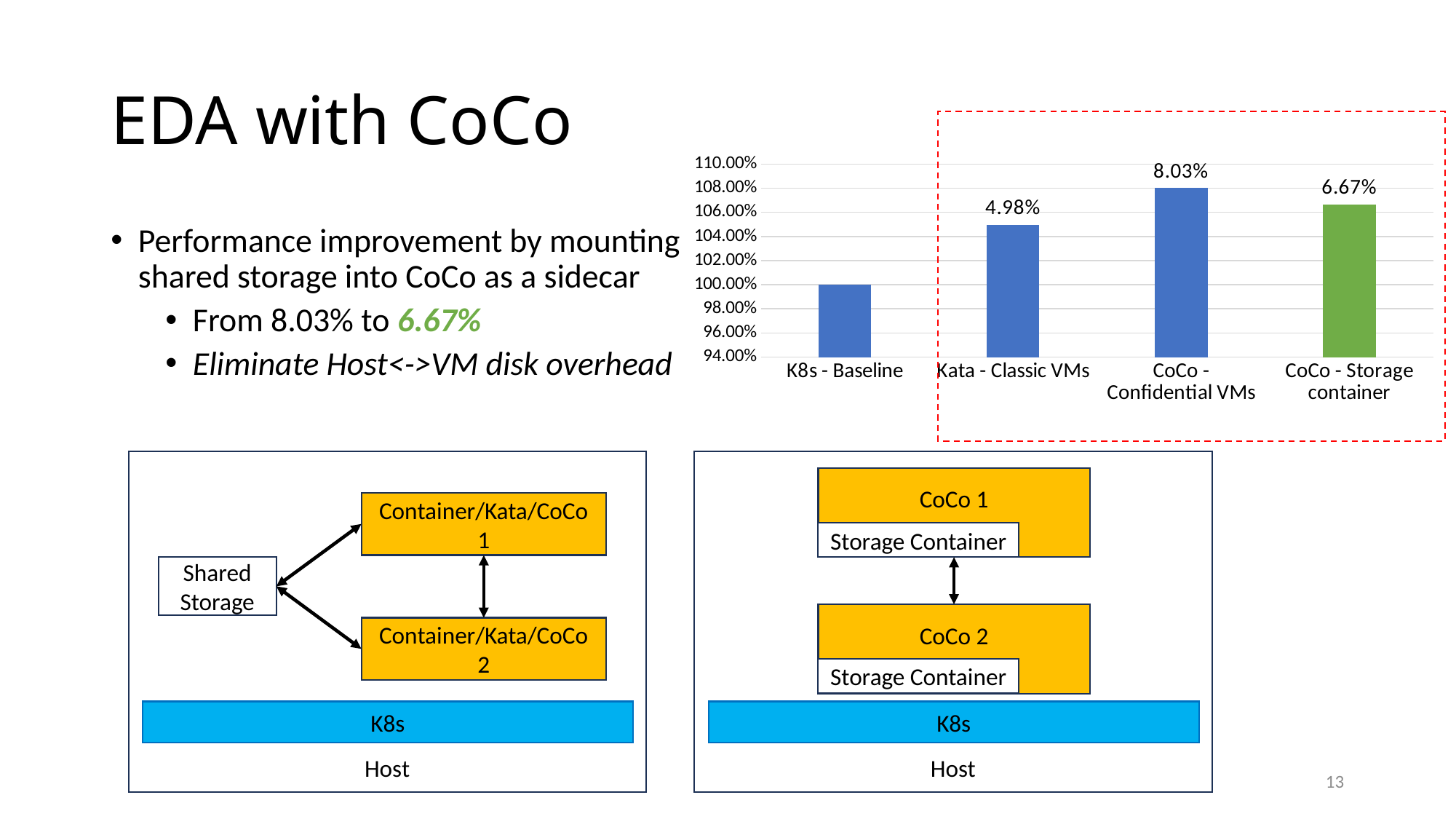
What data label is shown on the bar for CoCo - Storage container? 6.67% Which category has the shortest bar in the chart? K8s - Baseline Which category has the tallest bar in the chart? CoCo - Confidential VMs Which category's bar is coloured green in the chart? CoCo - Storage container What data label is shown on the bar for CoCo - Confidential VMs? 8.03% Is the bar for CoCo - Confidential VMs greater or less than 106.00% on the axis? greater Is the bar for K8s - Baseline greater or less than 102.00% on the axis? less What data label is shown on the bar for Kata - Classic VMs? 4.98% How many categories are shown on the x axis of the chart? 4 Which bar is taller: Kata - Classic VMs or CoCo - Storage container? CoCo - Storage container What is the difference between the data labels for CoCo - Confidential VMs and CoCo - Storage container? 1.36% What kind of chart is shown on the slide? bar chart